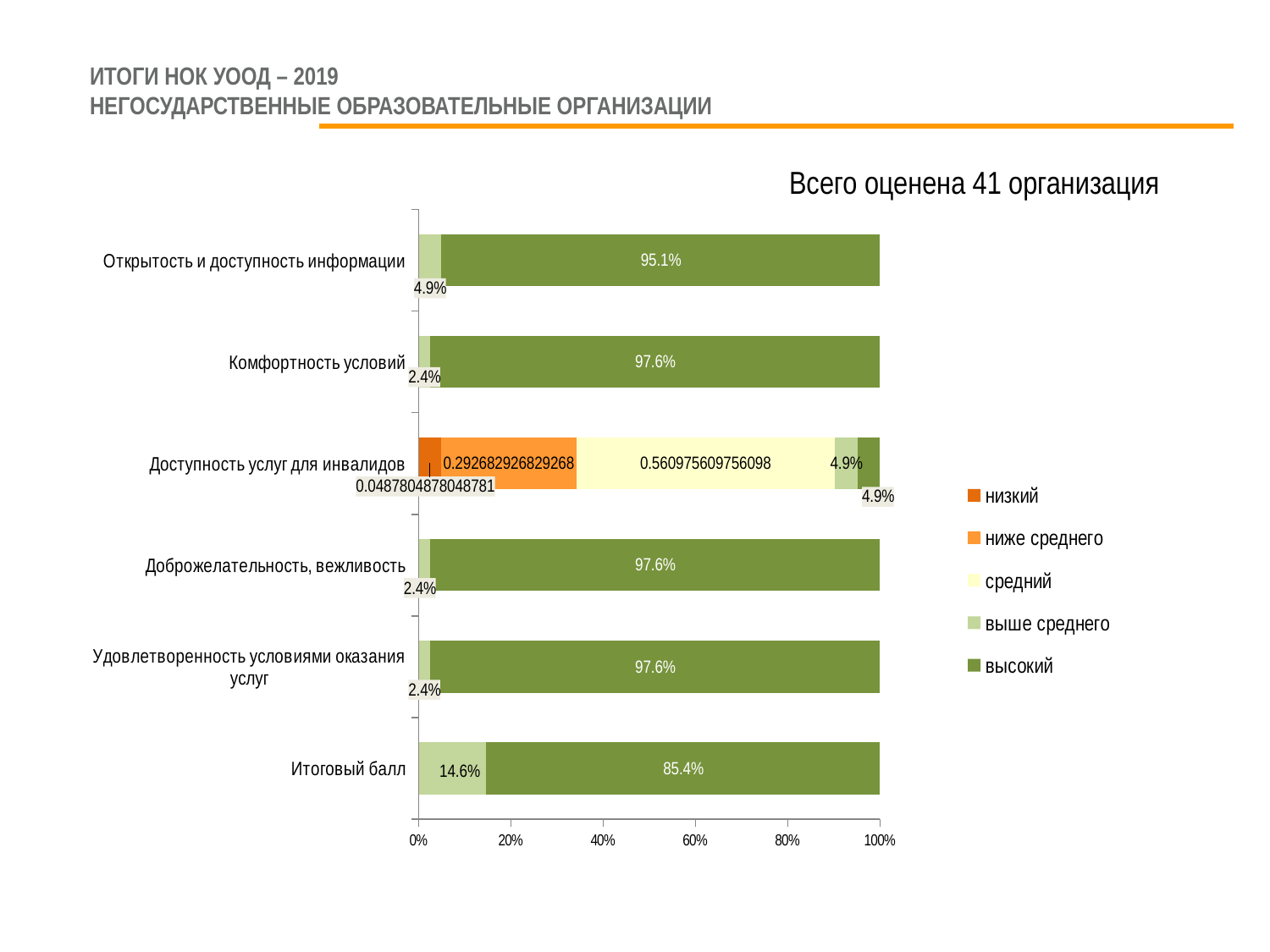
How many categories are plotted on the chart? 6 What is the value of the 'выше среднего' series for 'Итоговый балл'? 14.6% What is the value of the 'высокий' series for 'Открытость и доступность информации'? 95.1% What is the value of the 'высокий' series for 'Комфортность условий'? 97.6% What is the value of the 'ниже среднего' series for 'Доступность услуг для инвалидов'? 0.292682926829268 What is the difference between the 'высокий' values for 'Комфортность условий' and 'Итоговый балл'? 12.2% What is the value of the 'средний' series for 'Доступность услуг для инвалидов'? 0.560975609756098 How many series does the legend list? 5 According to the text above the chart, how many organisations were evaluated in total? 41 What kind of chart is shown on the slide? stacked bar chart Which category has the lowest value for the 'высокий' series? Доступность услуг для инвалидов Which is larger: the 'высокий' value for 'Открытость и доступность информации' or for 'Доброжелательность, вежливость'? Доброжелательность, вежливость